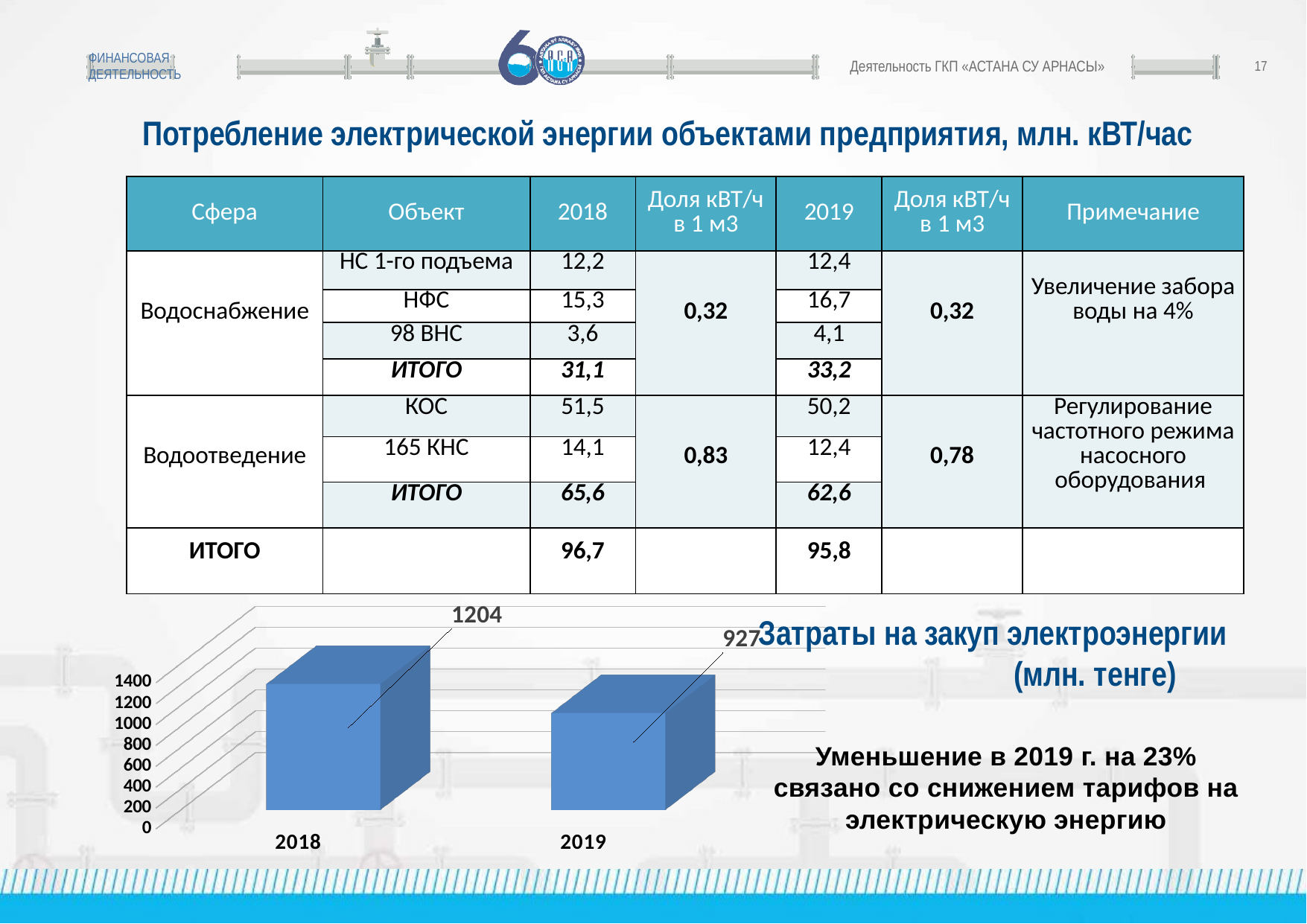
In the chart 'Затраты на закуп электроэнергии (млн. тенге)', is the value for 2018 greater or less than 1200? greater What is the maximum value shown on the vertical axis of the chart 'Затраты на закуп электроэнергии (млн. тенге)'? 1400 In the chart 'Затраты на закуп электроэнергии (млн. тенге)', what is the value for 2018? 1204 What is the title of the bar chart at the bottom of the slide? Затраты на закуп электроэнергии (млн. тенге) In the chart 'Затраты на закуп электроэнергии (млн. тенге)', do the values rise or fall from 2018 to 2019? fall In the chart 'Затраты на закуп электроэнергии (млн. тенге)', is the value for 2019 greater or less than 1000? less In the chart 'Затраты на закуп электроэнергии (млн. тенге)', which year has the higher value? 2018 How many bars are plotted in the chart 'Затраты на закуп электроэнергии (млн. тенге)'? 2 In the chart 'Затраты на закуп электроэнергии (млн. тенге)', which year has the lower value? 2019 What type of chart is shown at the bottom of the slide? Bar chart In the chart 'Затраты на закуп электроэнергии (млн. тенге)', what is the difference between the 2018 and 2019 values? 277 In the chart 'Затраты на закуп электроэнергии (млн. тенге)', what is the value for 2019? 927